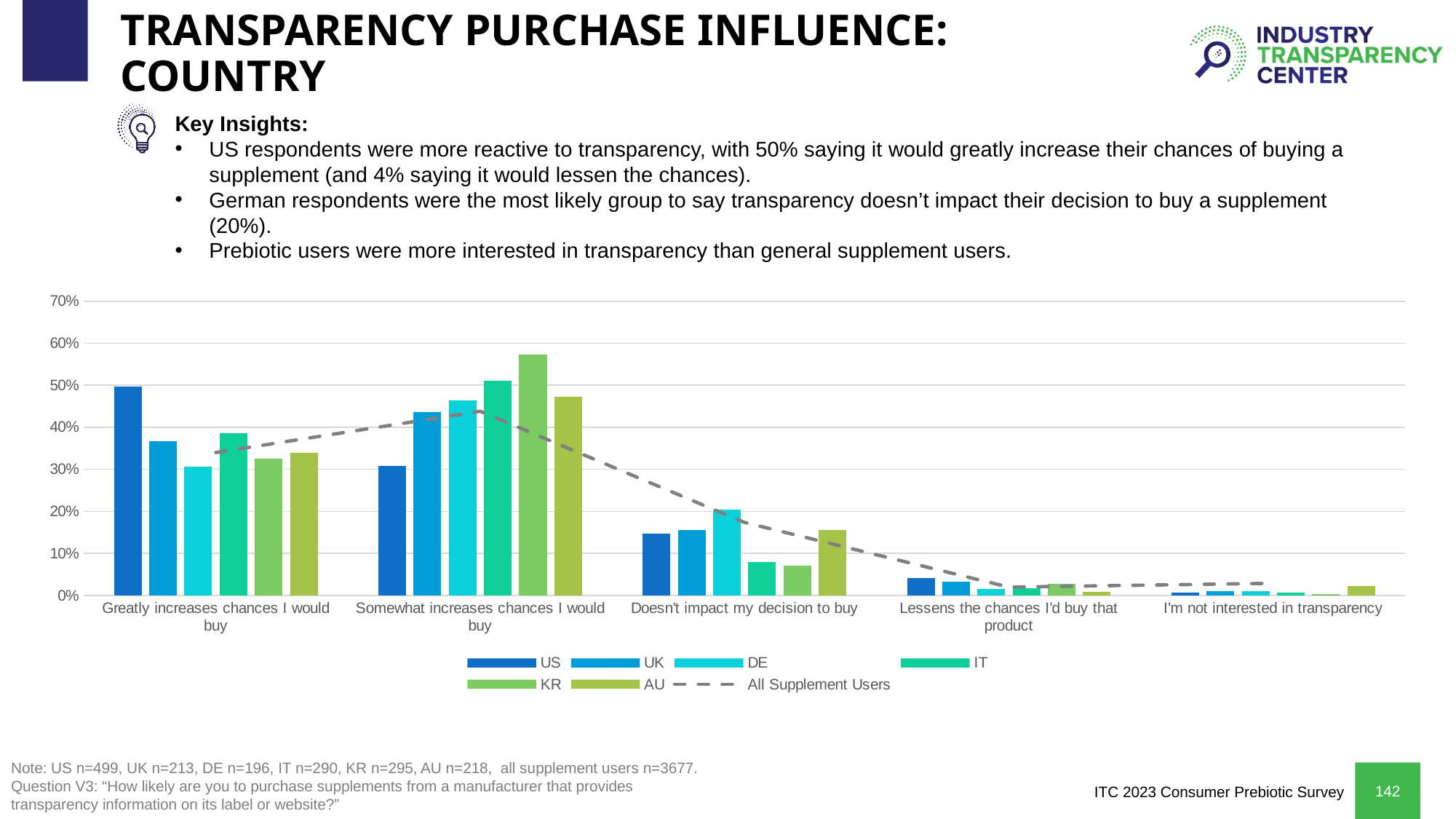
Which country has the highest bar for "Greatly increases chances I would buy"? US What kind of chart is shown on the slide? combination bar and line chart Is the US value for "Greatly increases chances I would buy" greater or less than 40%? greater Is the DE value for "Doesn't impact my decision to buy" greater or less than 10%? greater Which country has the lowest bar for "Somewhat increases chances I would buy"? US For "Greatly increases chances I would buy", which is larger, the US bar or the UK bar? US How many response categories are shown along the x axis of the chart? 5 Which country has the highest bar for "Somewhat increases chances I would buy"? KR Which country has the highest bar for "Doesn't impact my decision to buy"? DE How many series does the chart legend list? 7 What does the dashed grey line in the chart represent? All Supplement Users Is the KR value for "Somewhat increases chances I would buy" greater or less than 50%? greater